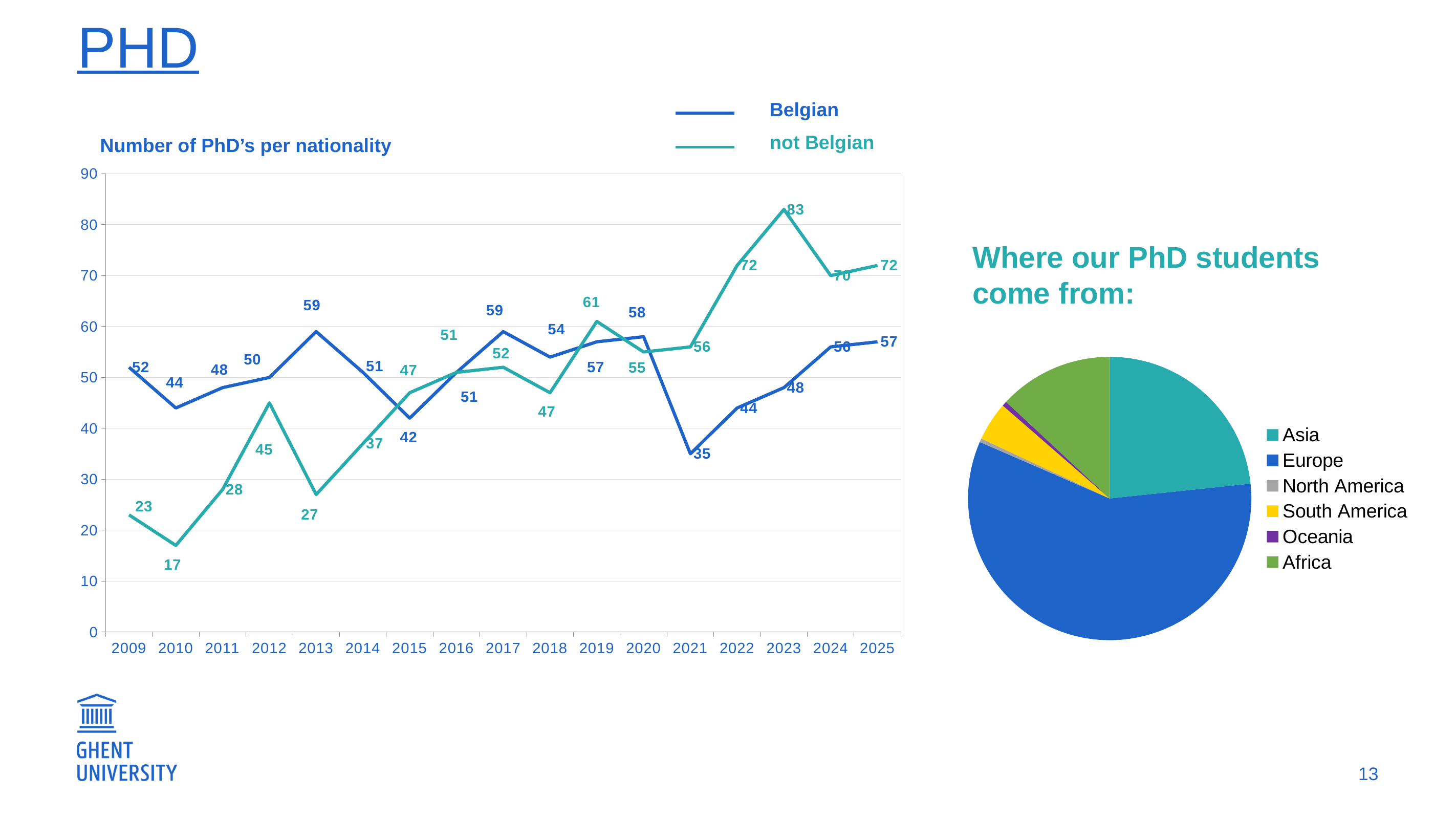
In the line chart 'Number of PhD's per nationality', what is the value for Belgian in 2013? 59 In the line chart 'Number of PhD's per nationality', how many series does the legend list? 2 In the line chart 'Number of PhD's per nationality', what is the value for not Belgian in 2023? 83 In the chart 'Where our PhD students come from:', which region has the largest slice? Europe In the chart 'Where our PhD students come from:', how many regions does the legend list? 6 In the line chart 'Number of PhD's per nationality', which series has the larger value in 2012, Belgian or not Belgian? Belgian In the line chart 'Number of PhD's per nationality', in which year is the Belgian series lowest? 2021 In the line chart 'Number of PhD's per nationality', what is the difference between not Belgian and Belgian in 2021? 21 In the line chart 'Number of PhD's per nationality', in which year is the not Belgian series highest? 2023 In the line chart 'Number of PhD's per nationality', what is the value for not Belgian in 2010? 17 In the line chart 'Number of PhD's per nationality', how many years are shown on the x axis? 17 What kind of chart is 'Number of PhD's per nationality'? line chart